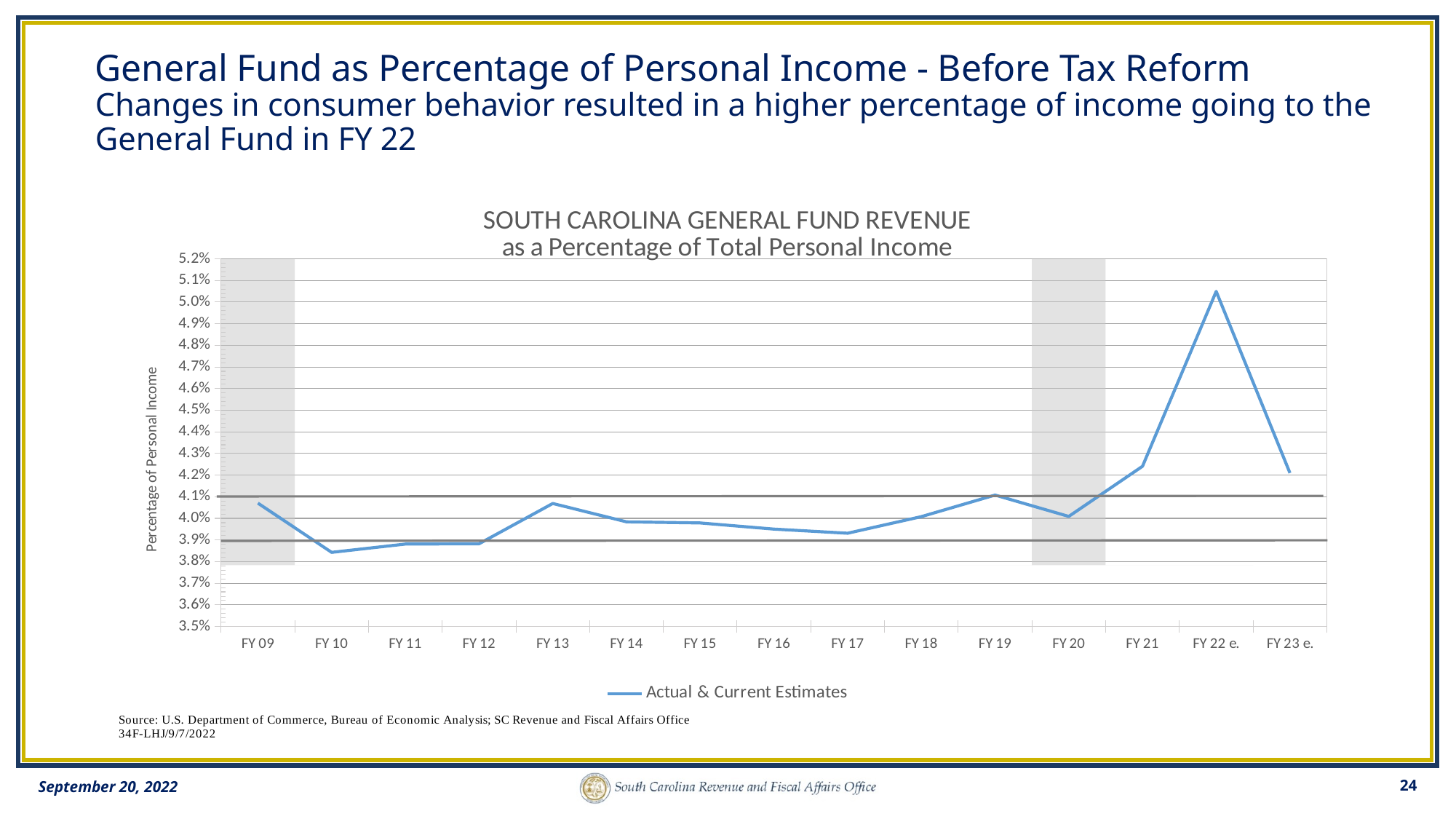
Which is larger, the value for FY 22 e. or the value for FY 23 e.? FY 22 e. How many fiscal years are plotted along the x axis? 15 Which fiscal year has the highest General Fund revenue as a percentage of personal income? FY 22 e. What is the name of the series shown in the legend? Actual & Current Estimates Is the value for FY 17 greater or less than 4.0%? less Is the value for FY 21 greater or less than 4.1%? greater What kind of chart is shown on the slide? line chart Is the value for FY 22 e. greater or less than 4.5%? greater Do the values rise or fall from FY 20 to FY 22 e.? rise Which fiscal year has the lowest General Fund revenue as a percentage of personal income? FY 10 How many series does the legend list? 1